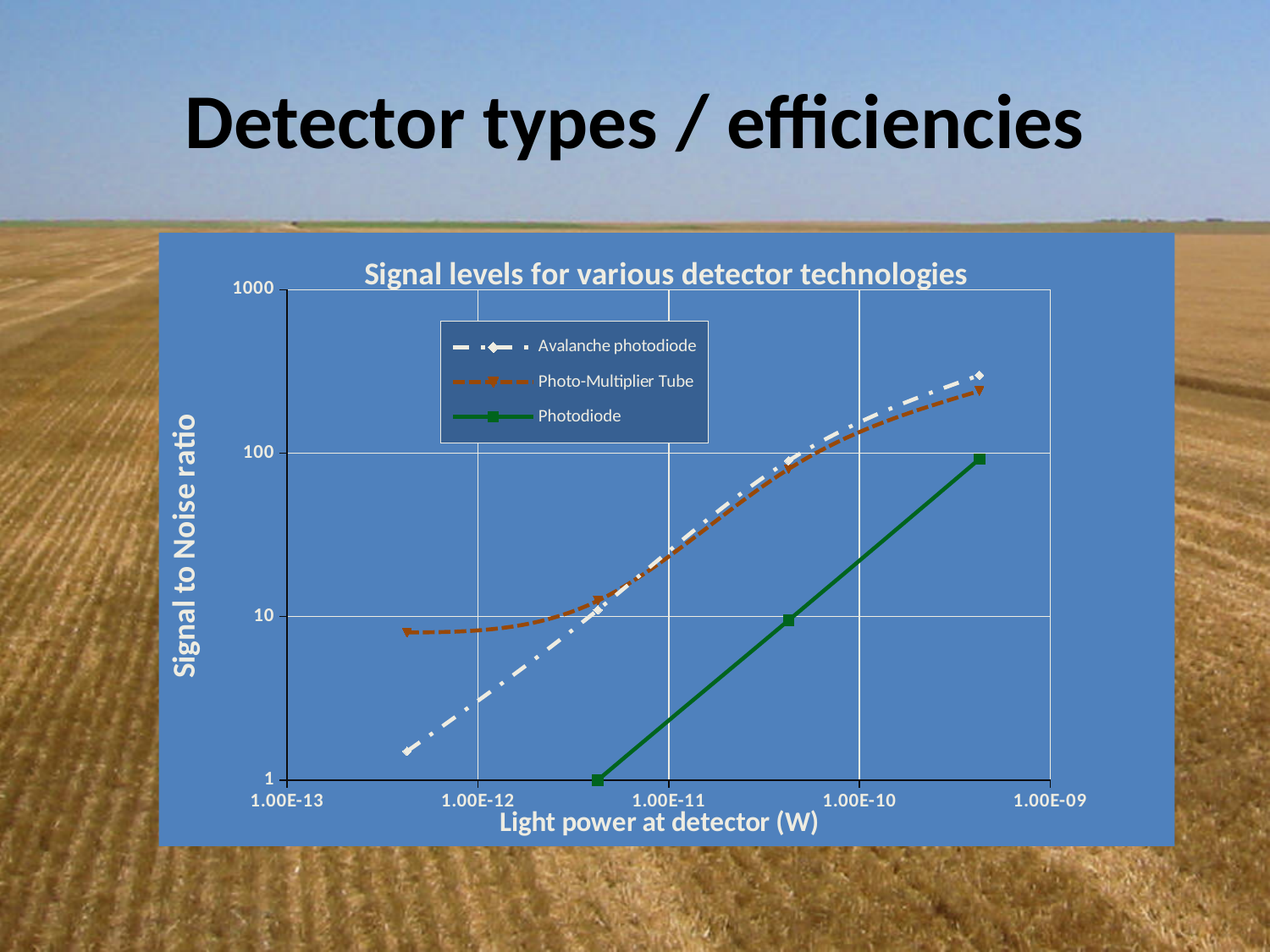
Does the Photodiode series rise or fall as light power increases along the x axis? rise How many series does the legend list? 3 Which series has the lowest signal to noise ratio at the right-hand end of the chart? Photodiode Is the highest value of the Avalanche photodiode series greater or less than 100? greater Does the Avalanche photodiode series rise or fall along the x axis? rise What is the label of the vertical axis? Signal to Noise ratio Which series starts at the lowest signal to noise ratio on the left side of the chart? Photodiode Is the leftmost value of the Avalanche photodiode series greater or less than 10? less What is the title of the chart? Signal levels for various detector technologies At the right-hand end of the chart, which series is higher: Photodiode or Photo-Multiplier Tube? Photo-Multiplier Tube Is the leftmost value of the Photo-Multiplier Tube series greater or less than 10? less What kind of chart is shown on the slide? line chart